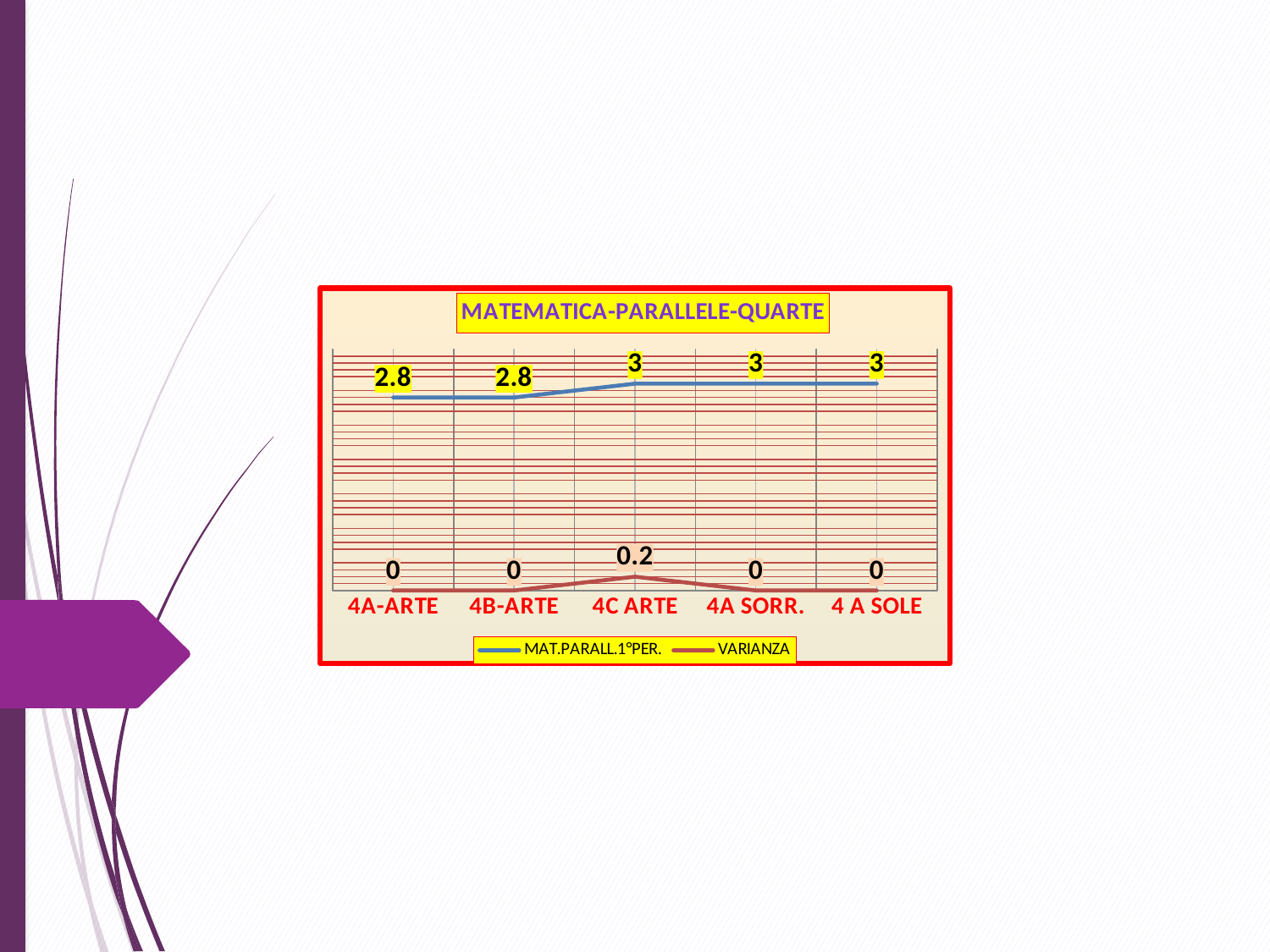
What kind of chart is shown on the slide? line chart How many categories are shown on the x axis? 5 What is the title of the chart? MATEMATICA-PARALLELE-QUARTE What is the VARIANZA value for 4A SORR.? 0 What is the MAT.PARALL.1°PER. value for 4A-ARTE? 2.8 Which is larger, the MAT.PARALL.1°PER. value for 4A SORR. or for 4A-ARTE? 4A SORR. Does the MAT.PARALL.1°PER. series rise or fall from 4A-ARTE to 4 A SOLE? rise What is the MAT.PARALL.1°PER. value for 4C ARTE? 3 What is the VARIANZA value for 4C ARTE? 0.2 Which category has the highest VARIANZA value? 4C ARTE How many series does the legend list? 2 What is the difference between the MAT.PARALL.1°PER. values for 4C ARTE and 4B-ARTE? 0.2